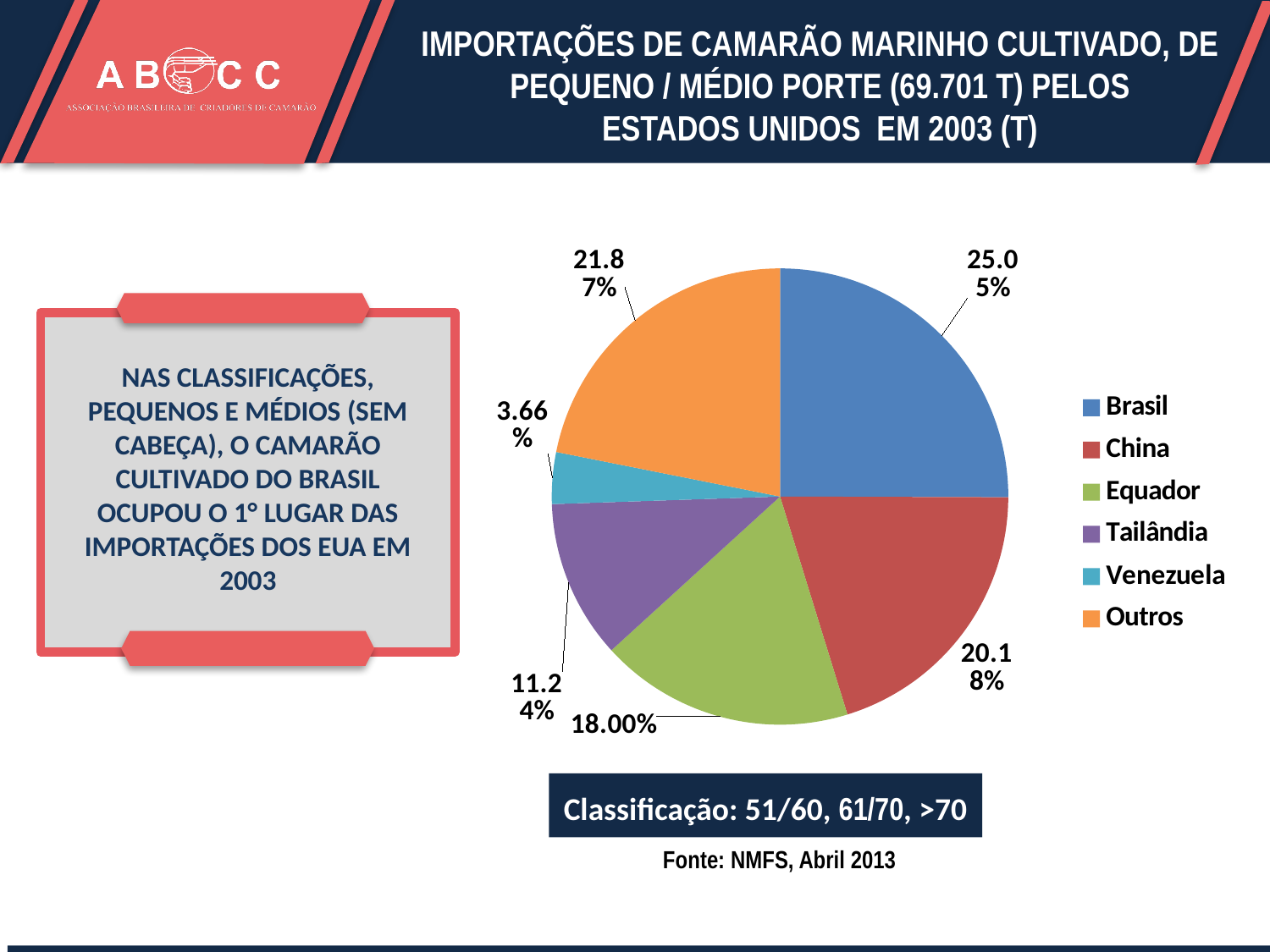
What is the value shown for Equador? 18.00% What is the value shown for Outros? 21.87% How many categories does the legend list? 6 What is the difference between the shares of Brasil and China? 4.87% Which category has the smallest slice of the pie? Venezuela Which is larger, the share for Equador or the share for Tailândia? Equador What kind of chart is shown on the slide? Pie chart What is the value shown for Venezuela? 3.66% What is the value shown for Tailândia? 11.24% What is the value shown for China? 20.18% Which category has the largest slice of the pie? Brasil What share of the pie does Brasil hold? 25.05%